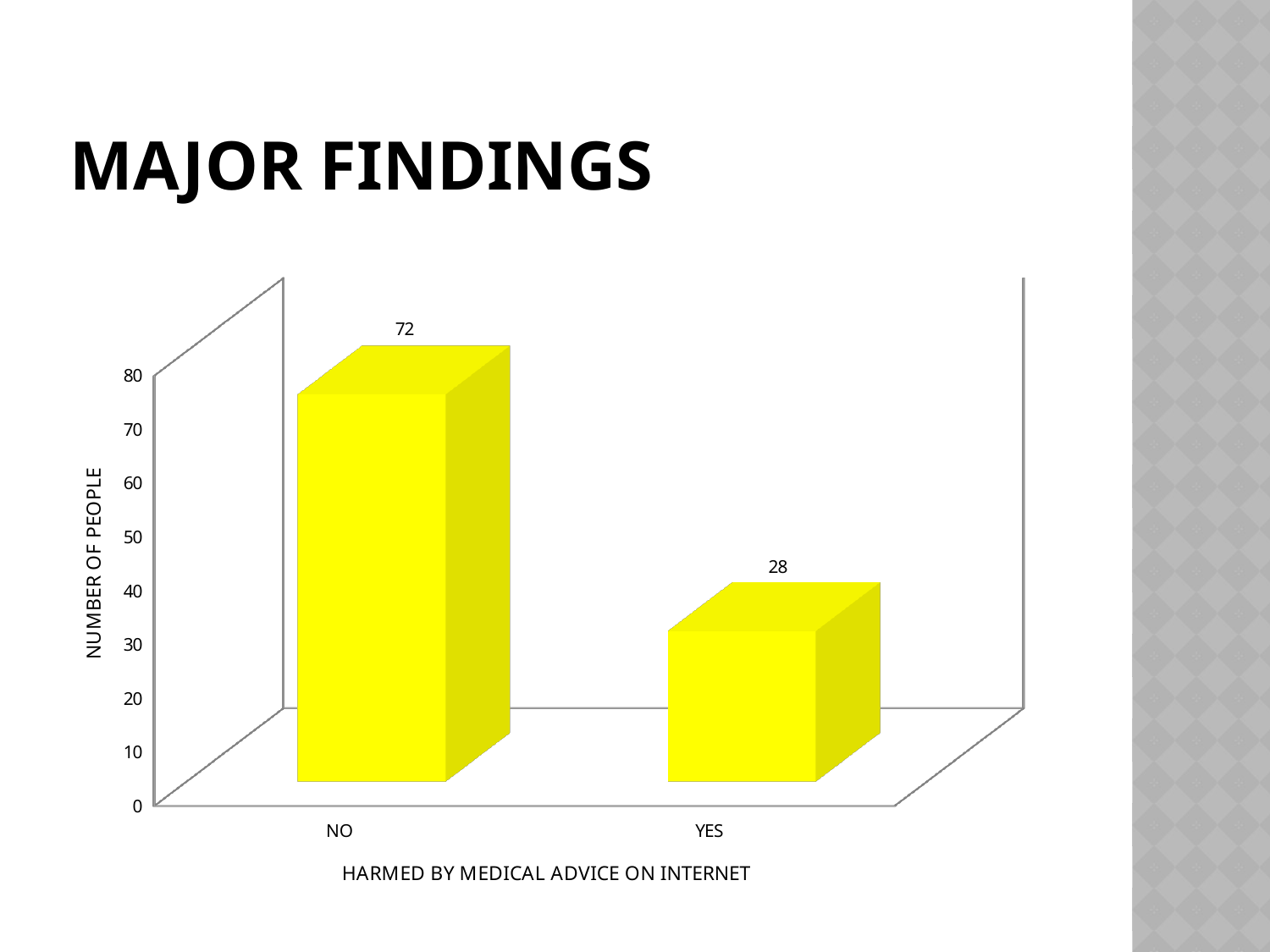
What kind of chart is shown on the slide? bar chart What is the difference between the number of people for NO and for YES? 44 Which category has the lowest number of people? YES What is the number of people for the YES category? 28 Which is larger, the value for NO or the value for YES? NO Which category has the highest number of people? NO What is the label of the y axis? NUMBER OF PEOPLE Is the value for YES greater or less than 30? less What is the label of the x axis? HARMED BY MEDICAL ADVICE ON INTERNET Is the value for NO greater or less than 70? greater What is the number of people for the NO category? 72 How many categories are shown on the x axis? 2